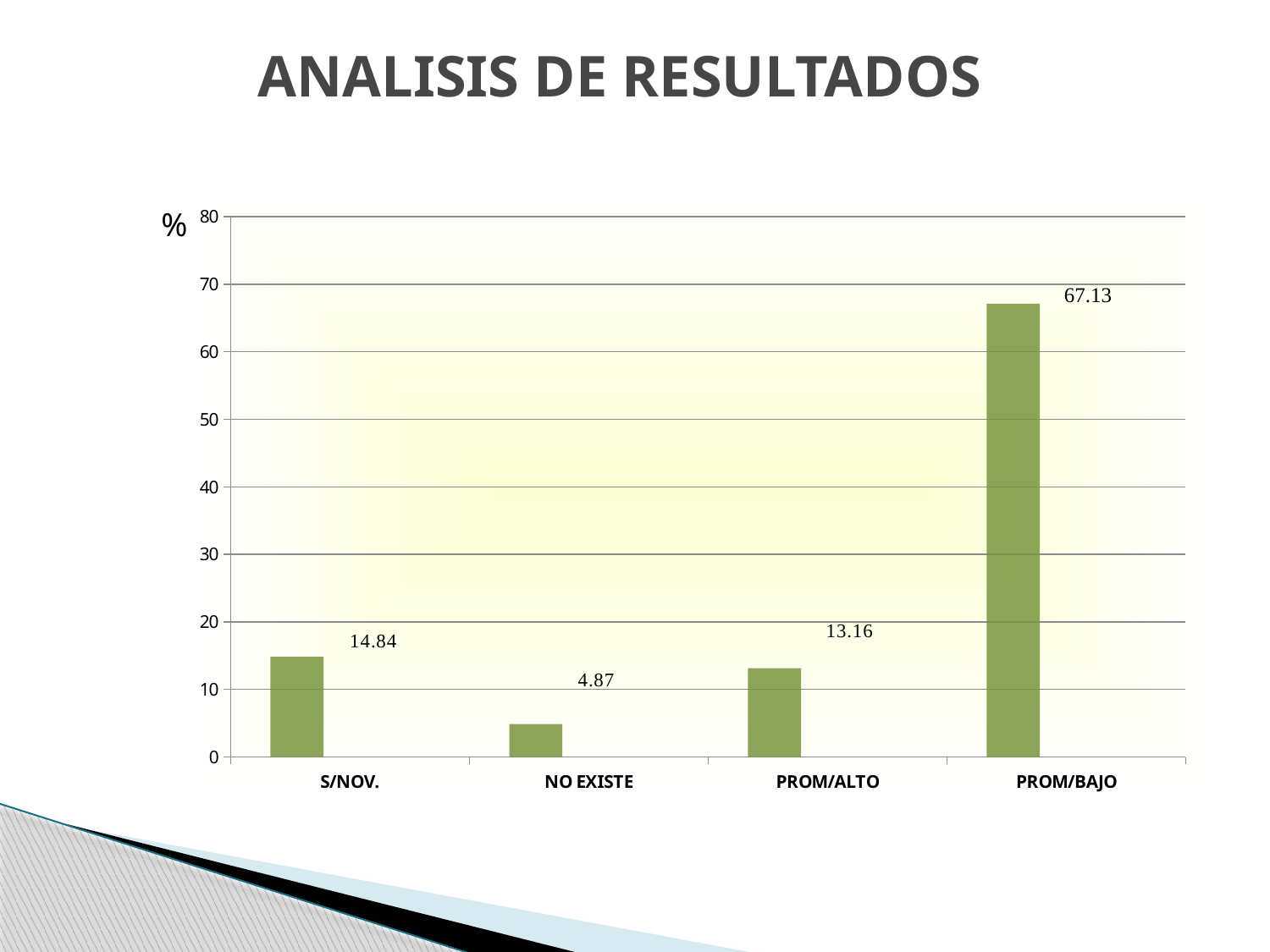
What is the difference between the values for PROM/BAJO and S/NOV.? 52.29 How many categories are shown on the x axis? 4 What kind of chart is shown on the slide? bar chart Is the value for PROM/BAJO greater or less than 60? greater What is the difference between the values for S/NOV. and PROM/ALTO? 1.68 What is the value for PROM/BAJO? 67.13 What is the value for PROM/ALTO? 13.16 Which category has the lowest value? NO EXISTE What is the value for NO EXISTE? 4.87 Which is larger, the value for S/NOV. or the value for NO EXISTE? S/NOV. Which category has the highest value? PROM/BAJO What is the value for S/NOV.? 14.84